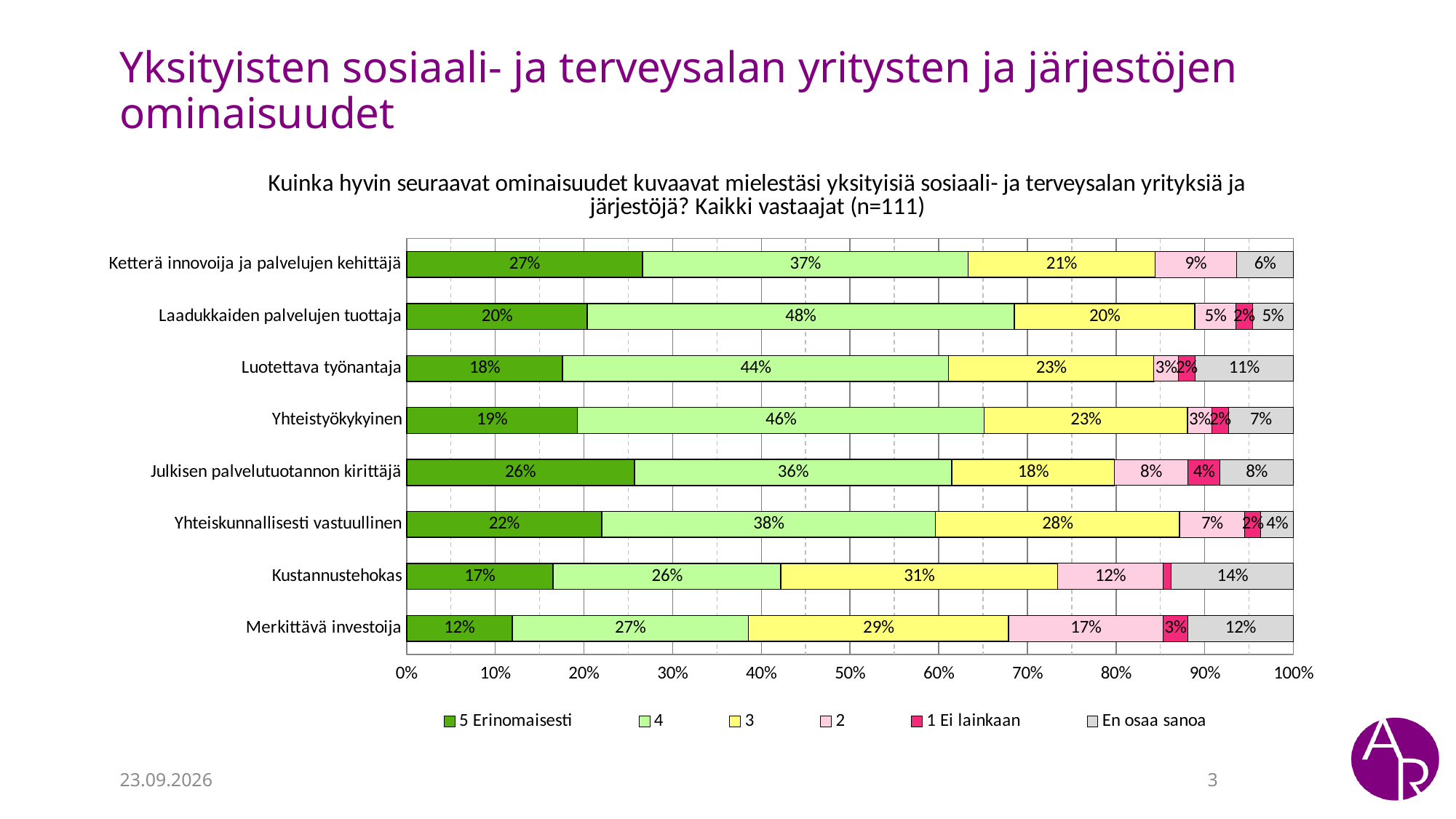
What is the "En osaa sanoa" value for "Luotettava työnantaja"? 11% What percentage of respondents rated "Laadukkaiden palvelujen tuottaja" as 4? 48% What type of chart is shown on the slide? Stacked bar chart How many categories (characteristics) are shown in the chart? 8 What is the difference between the "4" values for "Laadukkaiden palvelujen tuottaja" and "Kustannustehokas"? 22 percentage points Which category has the lowest "5 Erinomaisesti" share? Merkittävä investoija Which category has the highest "En osaa sanoa" share? Kustannustehokas How many series does the legend list? 6 What is the sample size (n) stated in the chart title? n=111 Which category has the highest "5 Erinomaisesti" share? Ketterä innovoija ja palvelujen kehittäjä Which has a larger "3" share: "Kustannustehokas" or "Yhteiskunnallisesti vastuullinen"? Kustannustehokas What is the "5 Erinomaisesti" value for "Merkittävä investoija"? 12%